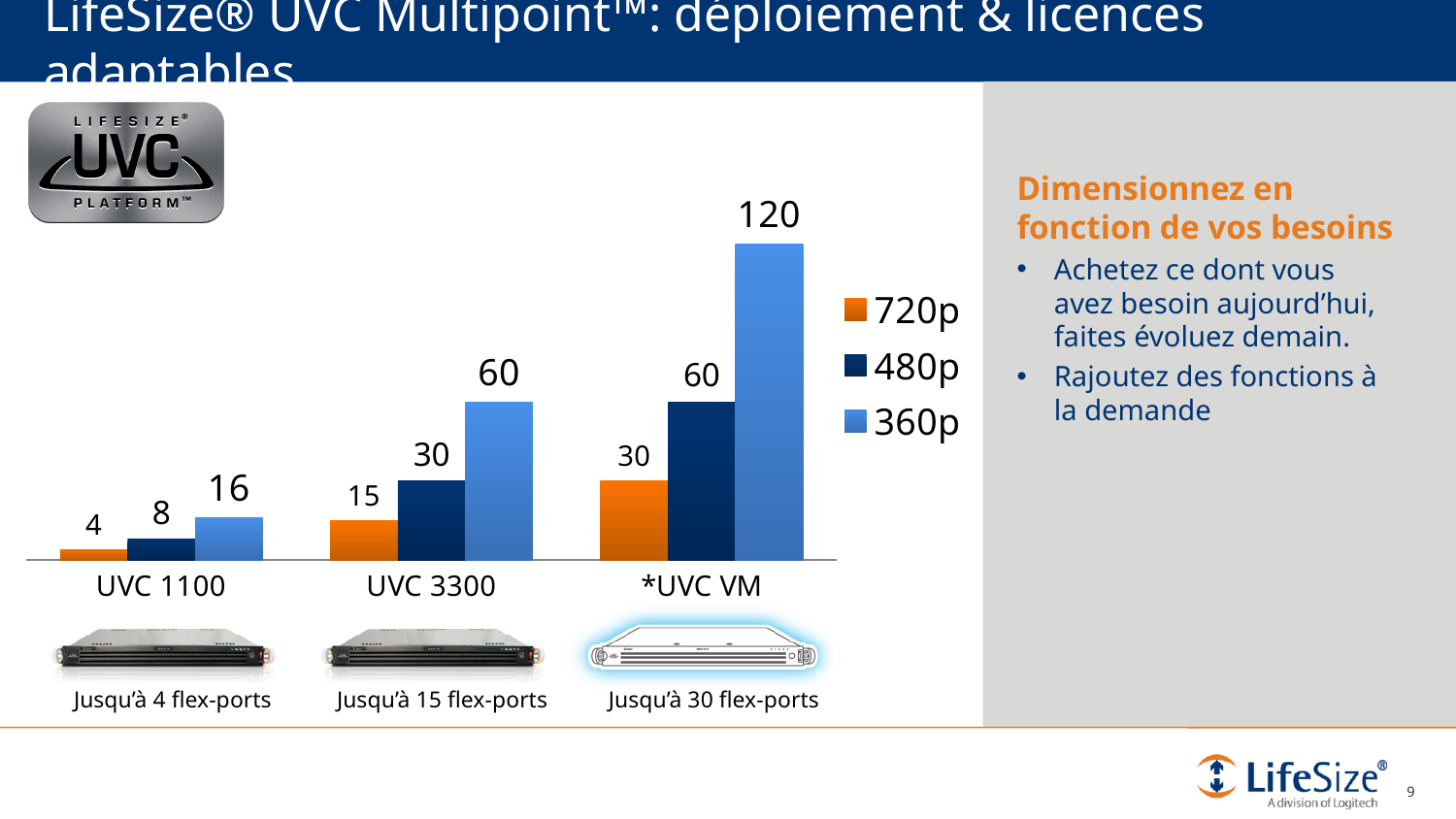
Do the 480p values rise or fall from UVC 1100 to *UVC VM? Rise What kind of chart is shown? Bar chart Which category has the highest 360p value? *UVC VM What is the difference between the 360p values for *UVC VM and UVC 3300? 60 Which category has the lowest 720p value? UVC 1100 How many categories are shown on the x axis? 3 How many series does the legend list? 3 Which is larger: the 480p value for UVC 3300 or the 720p value for *UVC VM? They are equal (30) Which series is shown in orange in the legend? 720p What is the 480p value for UVC 1100? 8 What is the 720p value for UVC 3300? 15 What is the 360p value for *UVC VM? 120